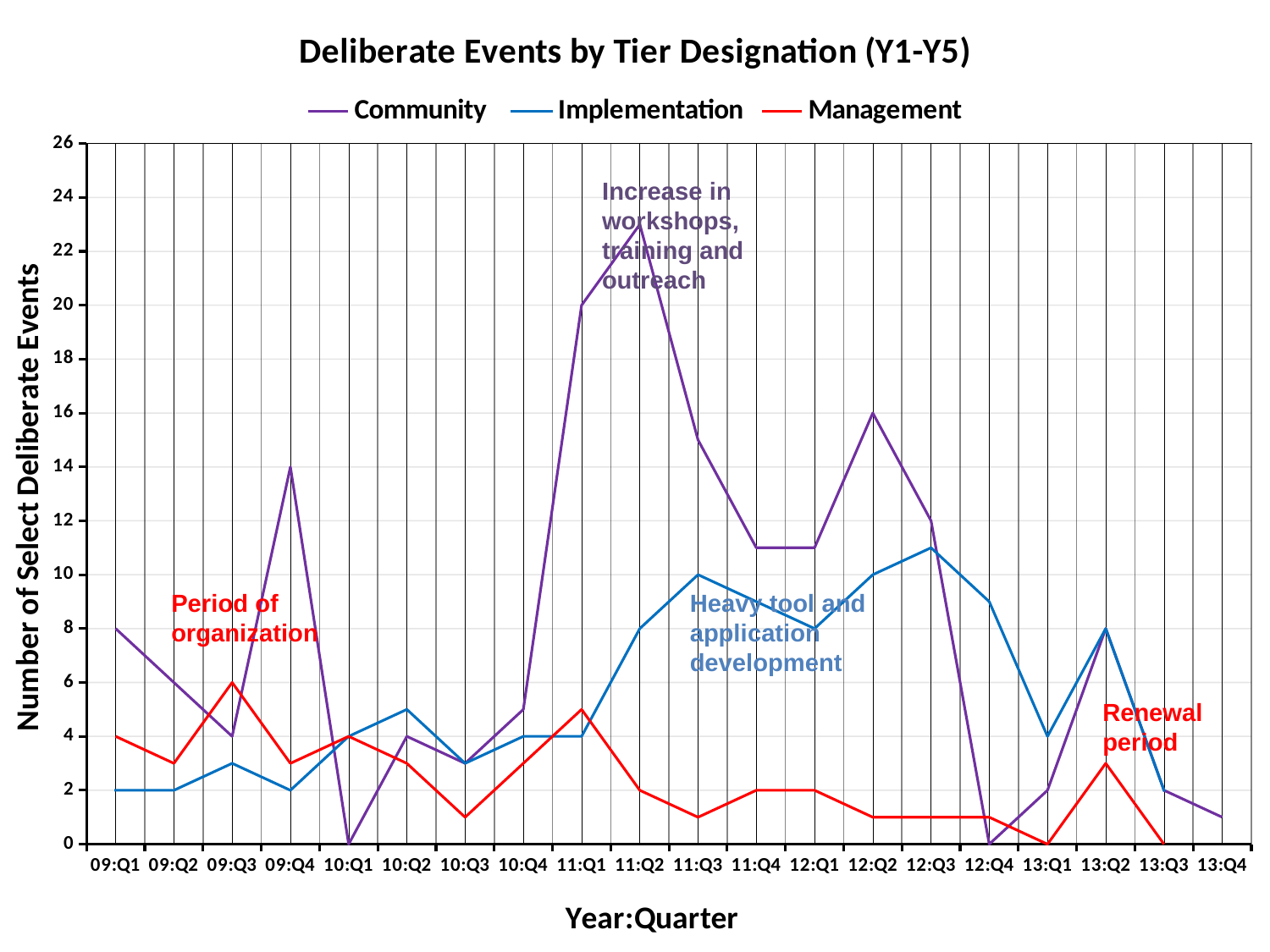
In which quarter does the Community series reach its highest value? 11:Q2 What is the title of the chart? Deliberate Events by Tier Designation (Y1-Y5) What is the value for Management in 09:Q3? 6 How many series does the legend list? 3 How many quarters are shown along the x axis? 20 Is the value for Community in 11:Q2 greater or less than 22? greater What kind of chart is shown on the slide? Line chart Which series has the higher value in 12:Q2, Community or Management? Community What is the value for Community in 11:Q1? 20 What is the difference between the Community values in 09:Q4 and 09:Q1? 6 What is the value for Implementation in 11:Q3? 10 What is the value for Community in 09:Q4? 14